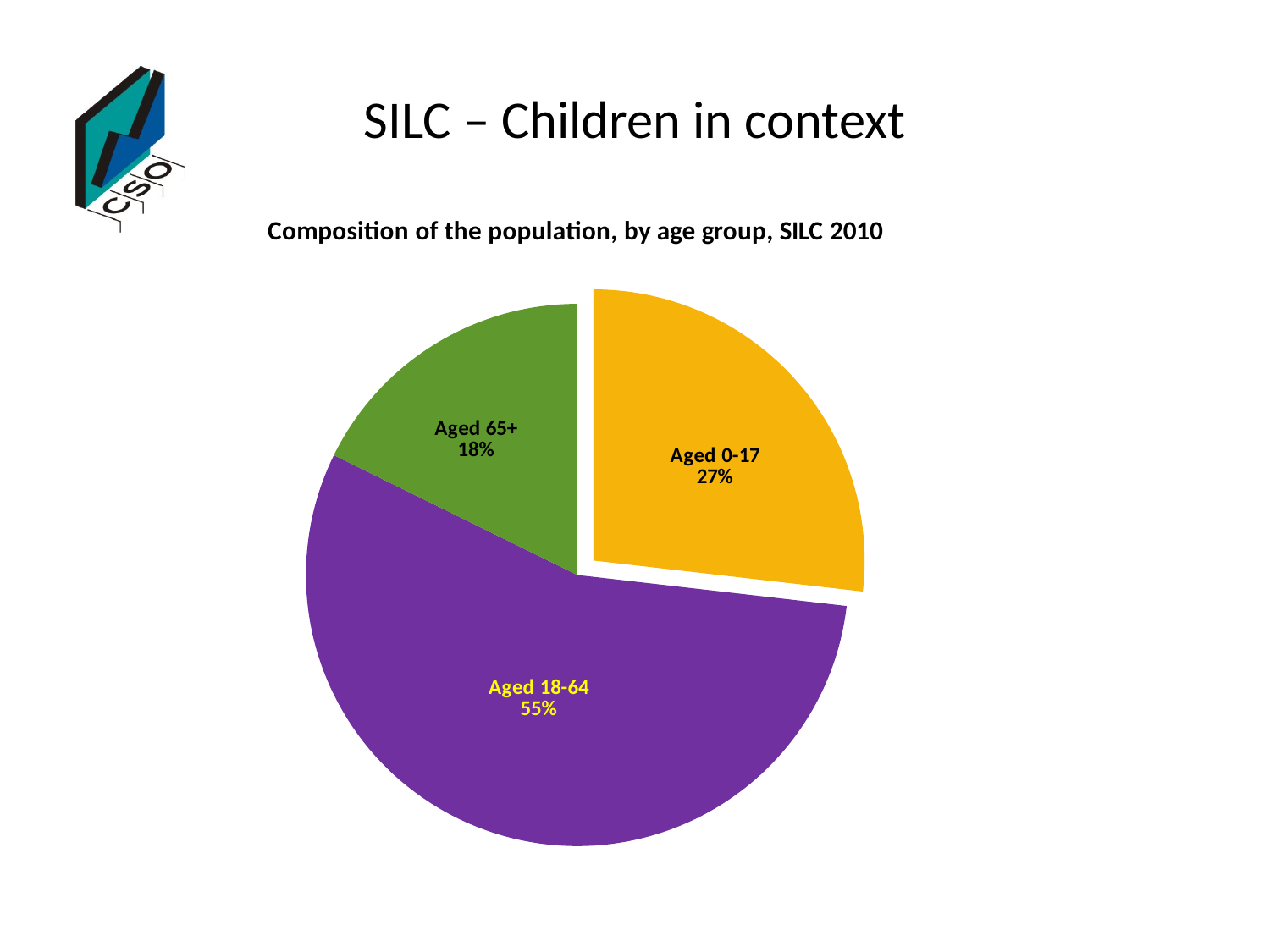
What share of the population is aged 65+? 18% What is the title of the chart? Composition of the population, by age group, SILC 2010 What share of the population is aged 0-17? 27% What colour is the slice for Aged 0-17? Yellow What share of the population is aged 18-64? 55% Which age group has the largest share of the population? Aged 18-64 What kind of chart is shown on the slide? Pie chart What is the difference in percentage points between the share aged 0-17 and the share aged 65+? 9 How many age groups are shown in the pie chart? 3 What is the difference in percentage points between the share aged 18-64 and the share aged 0-17? 28 Which age group has the smallest share of the population? Aged 65+ Which is larger, the share aged 0-17 or the share aged 65+? Aged 0-17